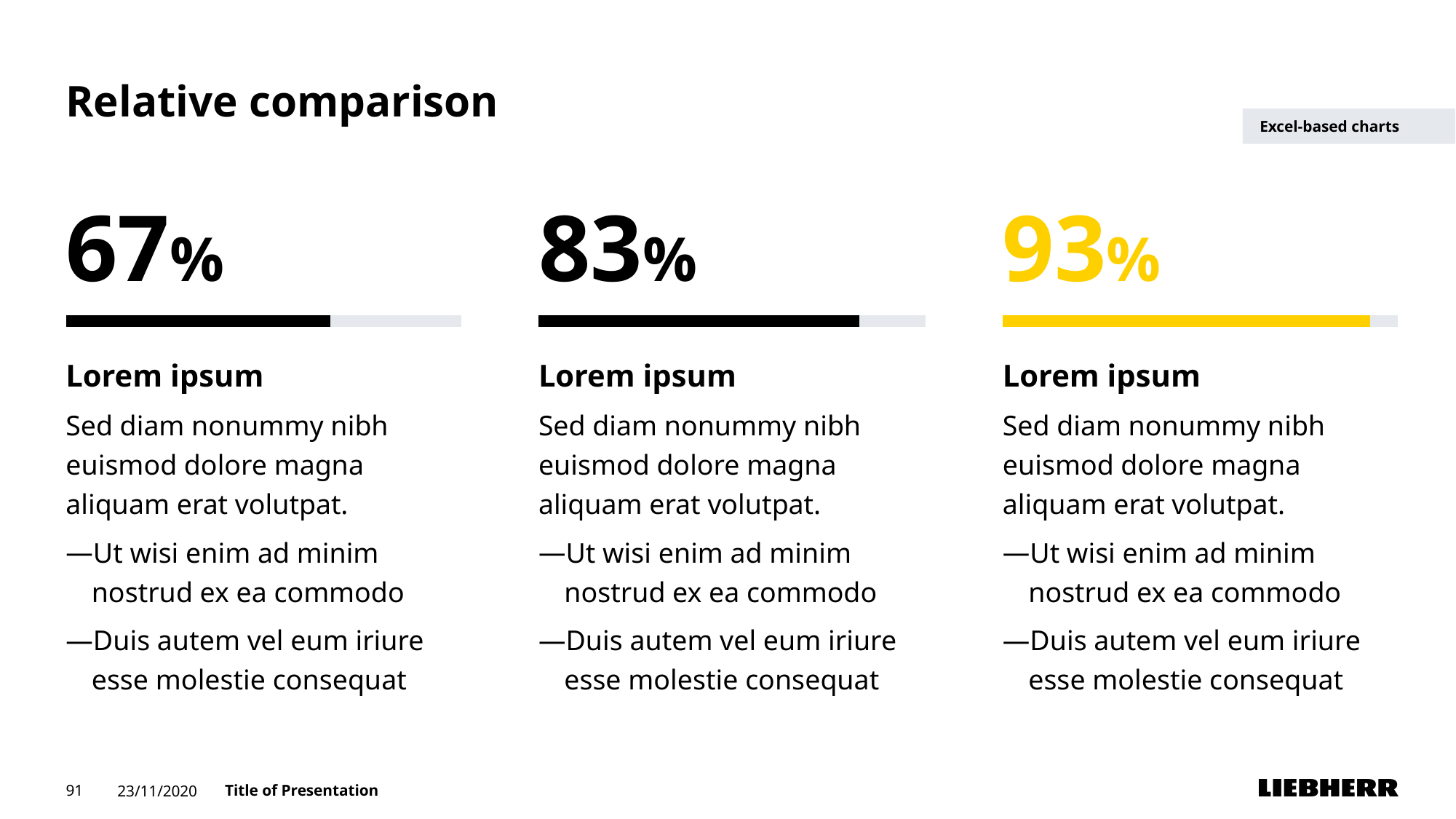
Which of the three progress bars shows the highest value? The right one (93%) What value is shown above the right progress bar? 93% Do the percentage values rise or fall from left to right across the slide? Rise Which is larger, the value of the middle bar or the value of the right bar? The right bar (93%) What is the difference between the right bar's value and the left bar's value? 26% Which of the three progress bars shows the lowest value? The left one (67%) What value is shown above the middle progress bar? 83% Which progress bar is coloured yellow rather than black? The right one (93%) How many progress bars are shown on the slide? 3 What value is shown above the left progress bar? 67% What kind of chart is used to show each percentage on the slide? Bar chart (horizontal progress bar) What is the difference between the middle bar's value and the left bar's value? 16%